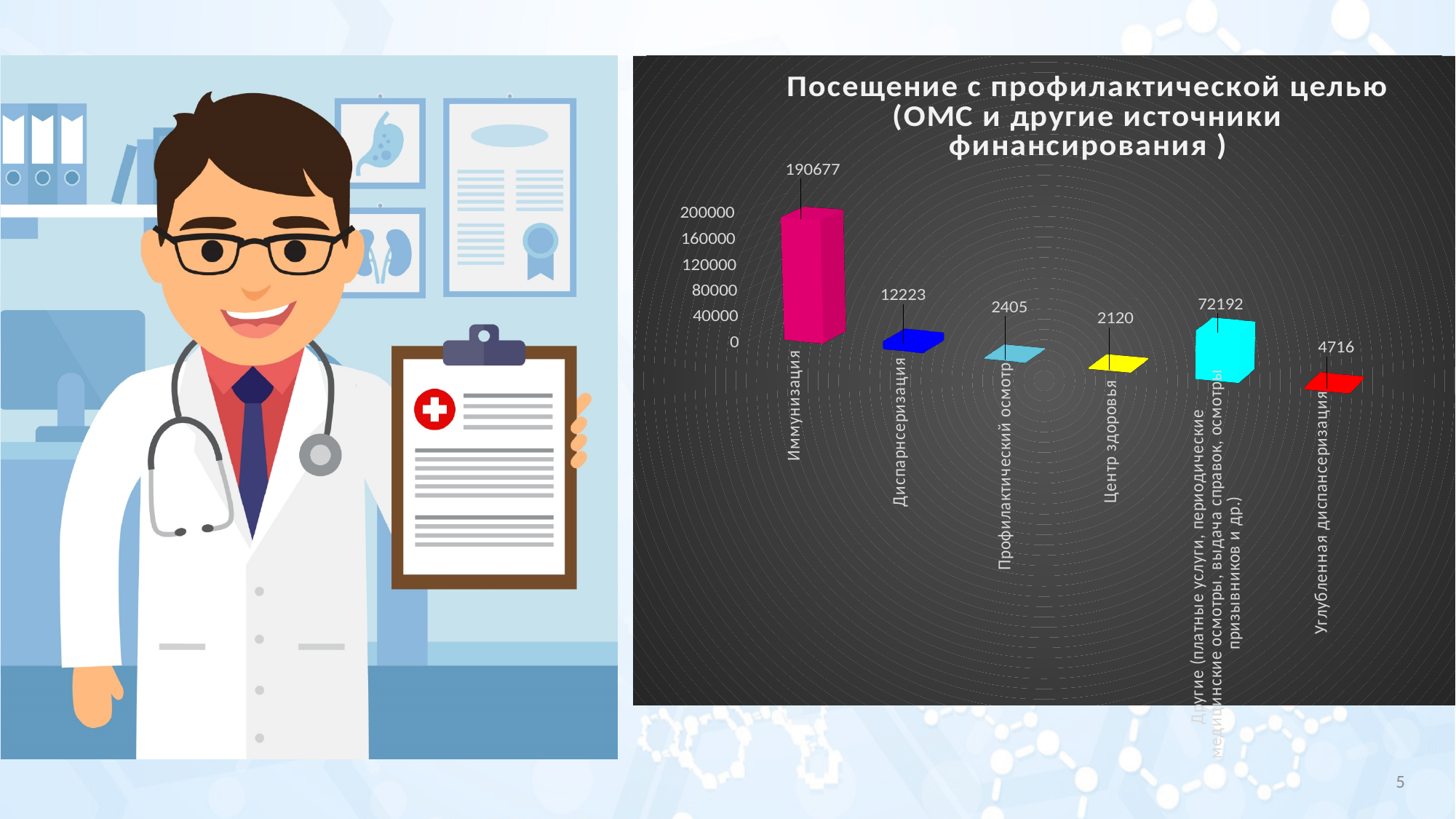
What is the value for Диспарнсеризация? 12223 Which category has the highest value? Иммунизация What is the value for Иммунизация? 190677 Which is larger, the value for Углубленная диспансеризация or the value for Профилактический осмотр? Углубленная диспансеризация Which category has the lowest value? Центр здоровья What is the value for Углубленная диспансеризация? 4716 What is the value for Центр здоровья? 2120 What is the value for Профилактический осмотр? 2405 What is the difference between the values for Иммунизация and Диспарнсеризация? 178454 How many categories are shown in the chart? 6 What kind of chart is shown on the slide? bar chart Is the value for Иммунизация greater or less than 160000? greater